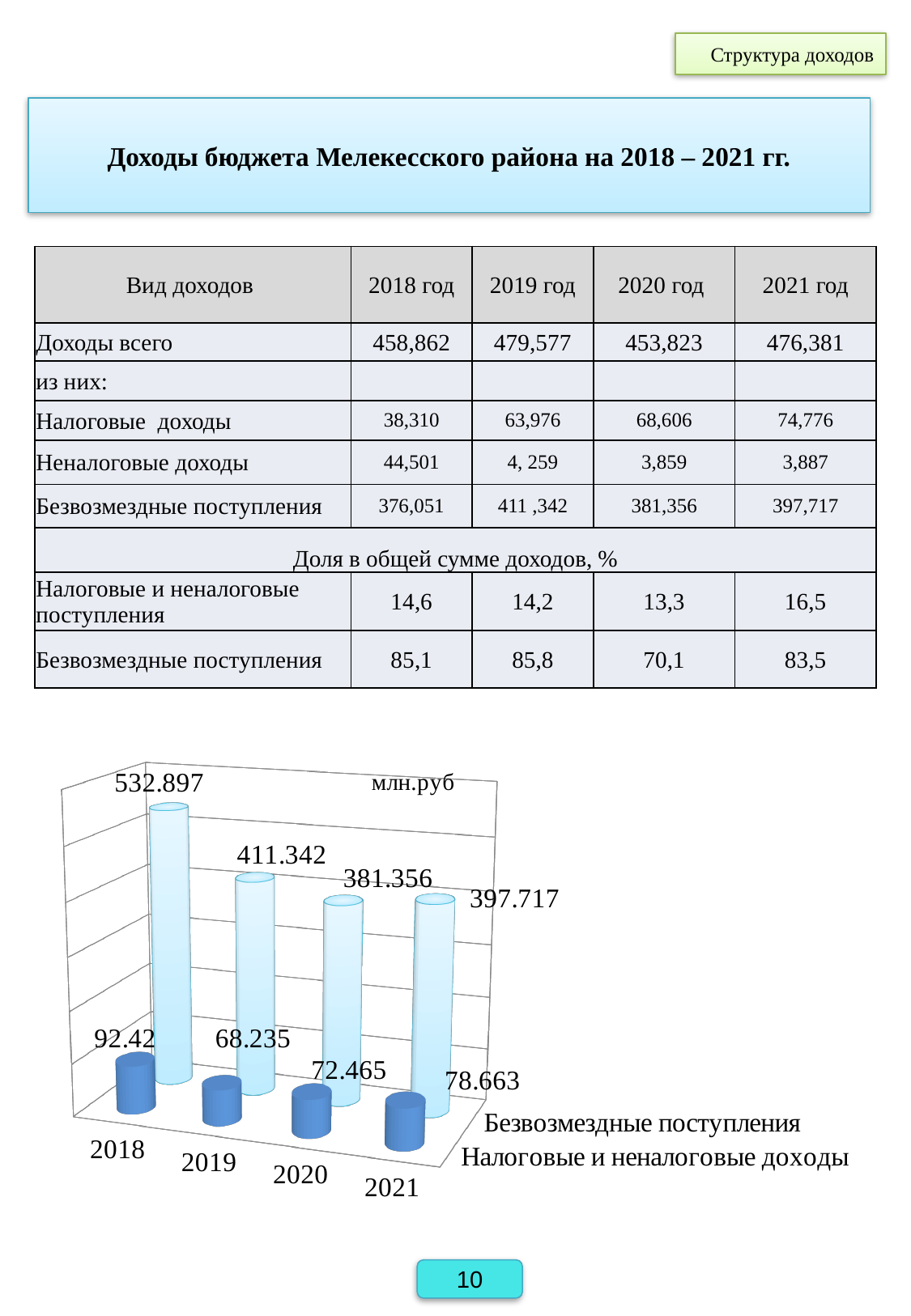
What is the value for Налоговые и неналоговые доходы in 2019 on the chart? 68.235 Which is larger on the chart: Налоговые и неналоговые доходы in 2021 or in 2020? 2021 How many series does the chart show? 2 What is the value for Безвозмездные поступления in 2018 on the chart? 532.897 How many years are shown on the chart's x axis? 4 What is the value for Налоговые и неналоговые доходы in 2020 on the chart? 72.465 In which year is Налоговые и неналоговые доходы lowest on the chart? 2019 What is the value for Безвозмездные поступления in 2021 on the chart? 397.717 In which year is Безвозмездные поступления lowest on the chart? 2020 What is the difference between Безвозмездные поступления in 2018 and 2019 on the chart? 121.555 What unit is indicated on the chart? млн.руб In which year is Безвозмездные поступления highest on the chart? 2018